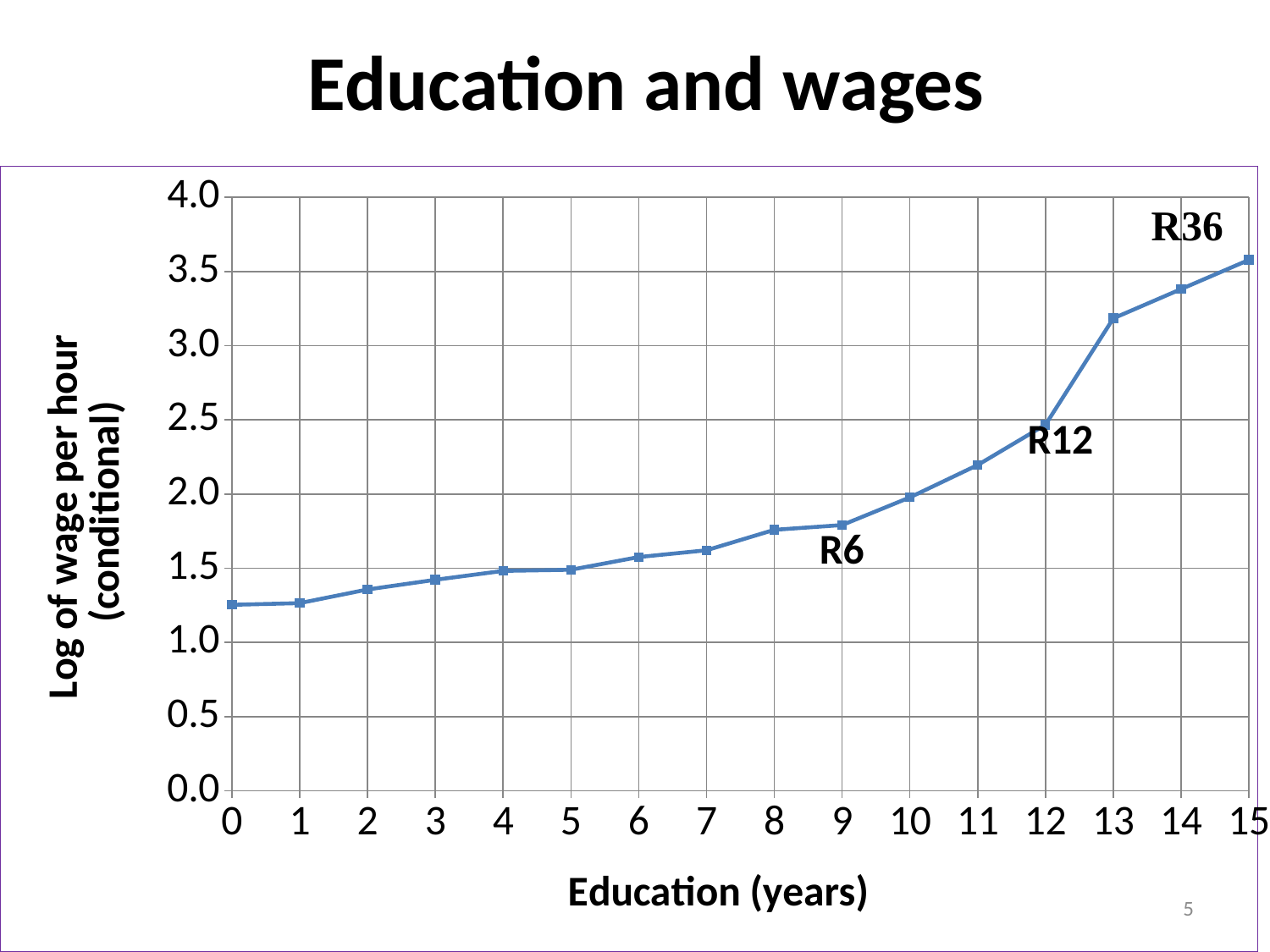
Is the value at 14 years of education greater or less than 3.5? less Is the value at 13 years of education greater or less than 3.0? greater Which has the higher log of wage per hour: 9 years of education or 13 years of education? 13 years What is the title of the chart? Education and wages How many data points are plotted on the line? 16 What kind of chart is shown on the slide? line chart Is the value at 8 years of education greater or less than 1.5? greater Does the log of wage per hour rise or fall as education years increase from 0 to 15? rise At which education level is the log of wage per hour highest? 15 What is the label of the x axis? Education (years)